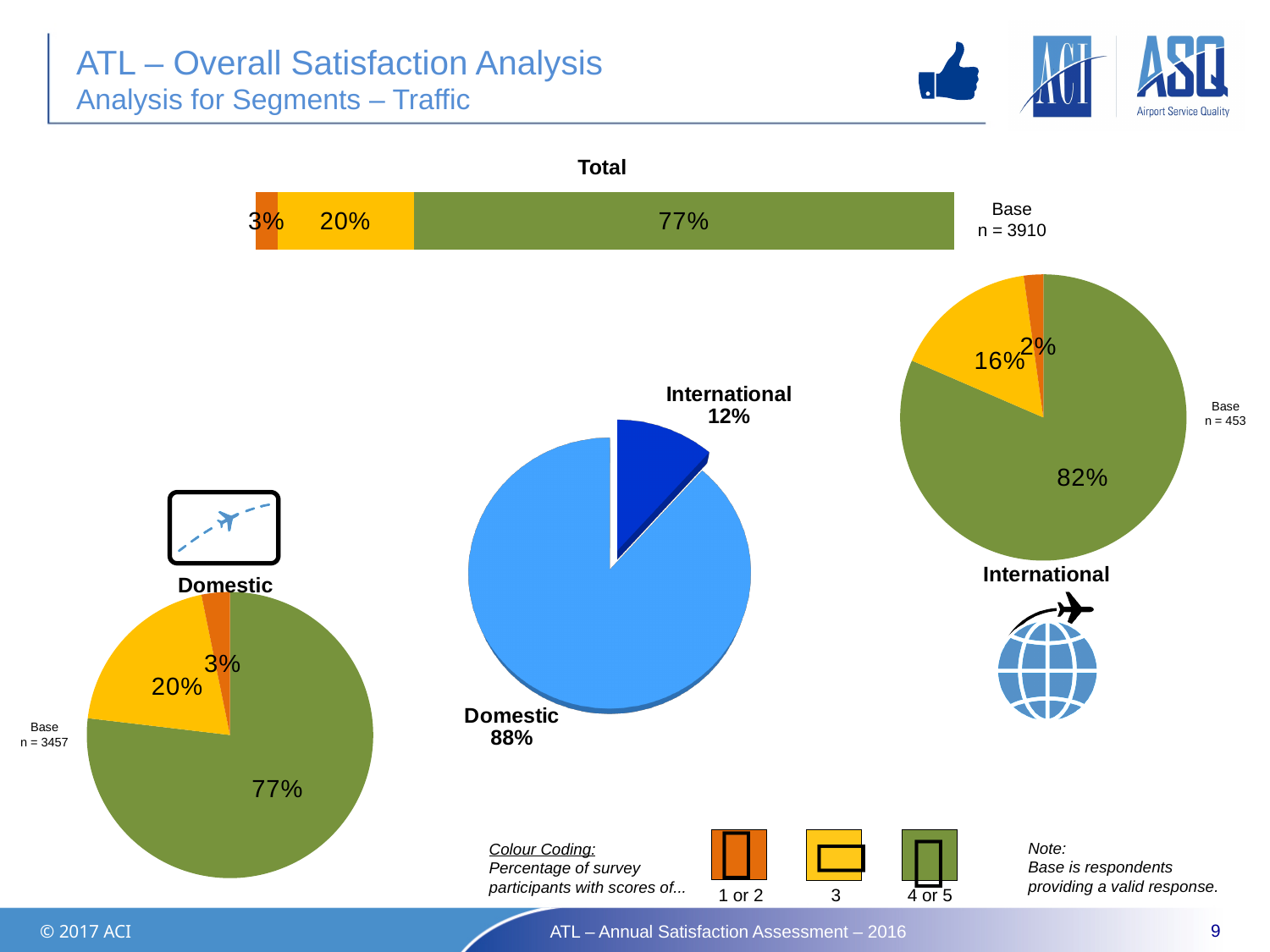
In the International pie chart, what percentage of respondents gave scores of 4 or 5? 82% Which is larger: the 4 or 5 share in the International pie chart or in the Domestic pie chart? International In the centre pie chart splitting traffic, what share is Domestic? 88% In the International pie chart, what percentage of respondents gave a score of 3? 16% In the Domestic pie chart, what percentage of respondents gave scores of 1 or 2? 3% What type of chart is used to show the Total satisfaction breakdown at the top of the slide? Bar chart In the Domestic pie chart, which score group has the smallest slice? 1 or 2 In the Total stacked bar chart, what percentage of respondents gave scores of 4 or 5? 77% In the Total stacked bar chart, what percentage of respondents gave scores of 1 or 2? 3% In the Total stacked bar chart, what percentage of respondents gave a score of 3? 20% What is the difference between the 4 or 5 share in the International pie chart (82%) and in the Domestic pie chart (77%)? 5% In the centre pie chart splitting traffic, what share is International? 12%